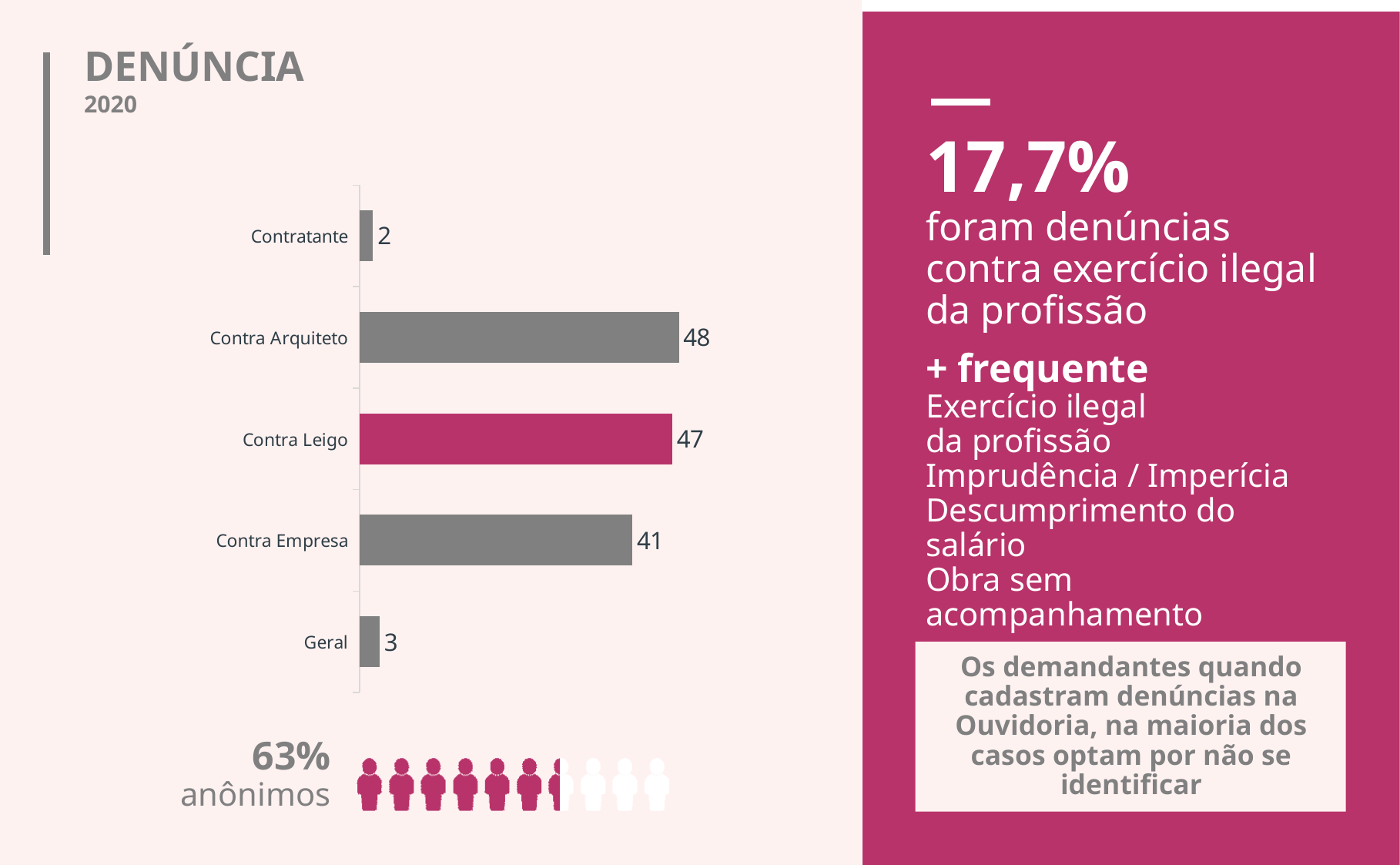
What is the value for Contratante? 2 Which category's bar is highlighted in a different colour (magenta) from the others? Contra Leigo What is the value for Contra Leigo? 47 What kind of chart is shown on the slide? bar chart What is the value for Contra Arquiteto? 48 What is the value for Geral? 3 What is the difference between the values for Contra Arquiteto and Contra Empresa? 7 How many categories are shown in the chart? 5 What is the value for Contra Empresa? 41 Which category has the highest value? Contra Arquiteto Which is larger, the value for Contra Leigo or the value for Contra Empresa? Contra Leigo Which category has the lowest value? Contratante